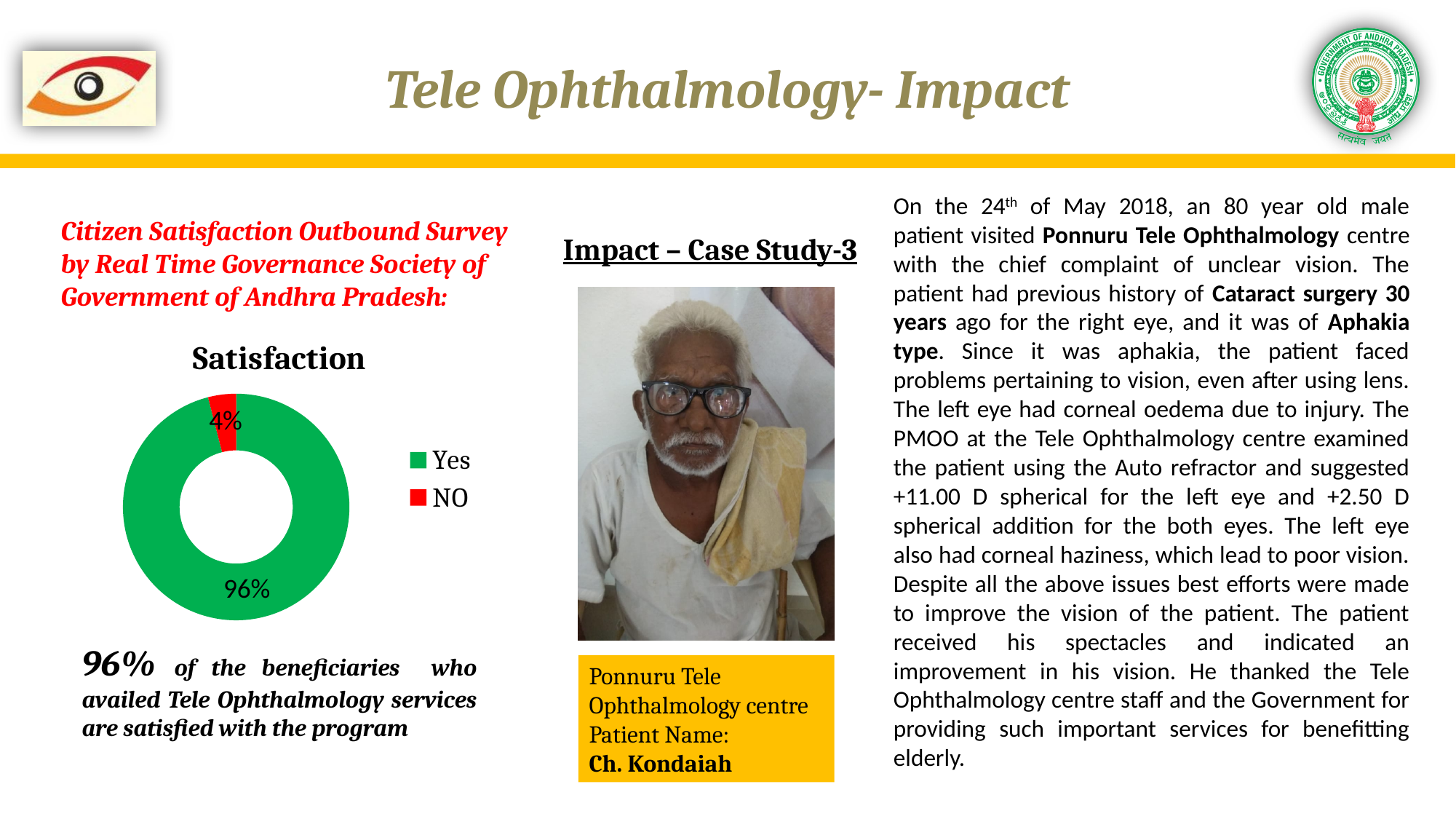
What percentage of the Satisfaction chart is labelled Yes? 96% Which category has the largest share in the Satisfaction chart? Yes What is the total of the Yes and NO shares in the Satisfaction chart? 100% In the Satisfaction chart, which is larger, the Yes share or the NO share? Yes How many categories does the legend of the Satisfaction chart list? 2 What percentage of the Satisfaction chart is labelled NO? 4% Which category has the smallest share in the Satisfaction chart? NO What is the title of the chart on the slide? Satisfaction What is the difference in percentage points between the Yes and NO shares in the Satisfaction chart? 92 What kind of chart is the Satisfaction chart? Doughnut chart What colour represents the NO category in the Satisfaction chart? Red